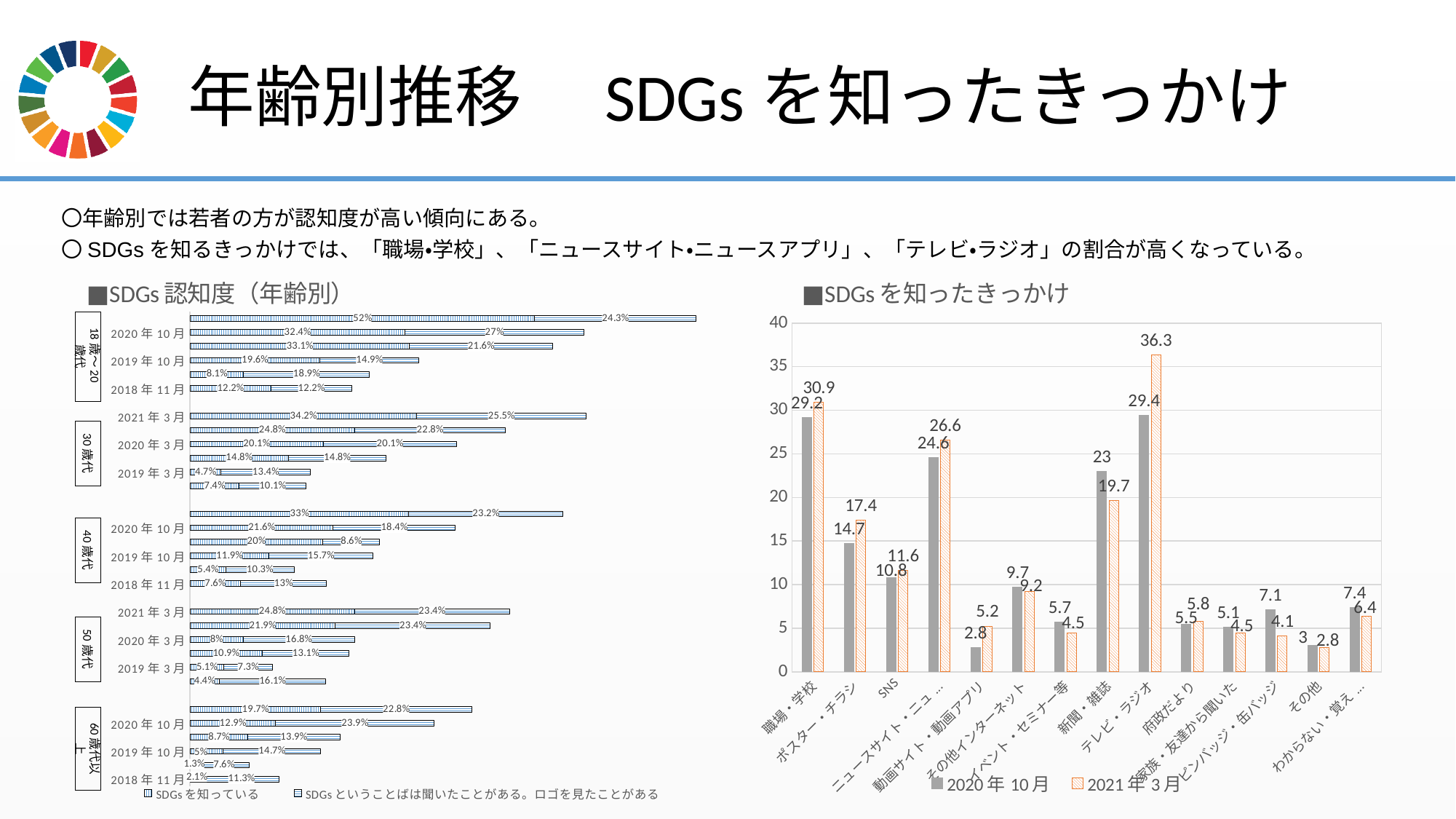
In the chart titled ■SDGsを知ったきっかけ, what is the value for テレビ・ラジオ in the 2021年3月 series? 36.3 In the chart titled ■SDGsを知ったきっかけ, which series has the larger value for ポスター・チラシ? 2021年3月 What kind of chart is the chart titled ■SDGsを知ったきっかけ? bar chart What are the two legend entries of the chart titled ■SDGs認知度（年齢別）? SDGsを知っている; SDGsということばは聞いたことがある。ロゴを見たことがある In the chart titled ■SDGsを知ったきっかけ, what is the difference between the 2021年3月 and 2020年10月 values for テレビ・ラジオ? 6.9 In the chart titled ■SDGsを知ったきっかけ, which category has the highest value in the 2021年3月 series? テレビ・ラジオ In the chart titled ■SDGsを知ったきっかけ, which category has the lowest value in the 2020年10月 series? 動画サイト・動画アプリ In the chart titled ■SDGsを知ったきっかけ, what is the value for 職場・学校 in the 2020年10月 series? 29.2 In the chart titled ■SDGsを知ったきっかけ, how much higher is the 2020年10月 value than the 2021年3月 value for 新聞・雑誌? 3.3 How many categories are shown on the x axis of the chart titled ■SDGsを知ったきっかけ? 14 How many series does the legend of the chart titled ■SDGsを知ったきっかけ list? 2 In the chart titled ■SDGsを知ったきっかけ, is the value for SNS in the 2021年3月 series greater or less than 10? greater